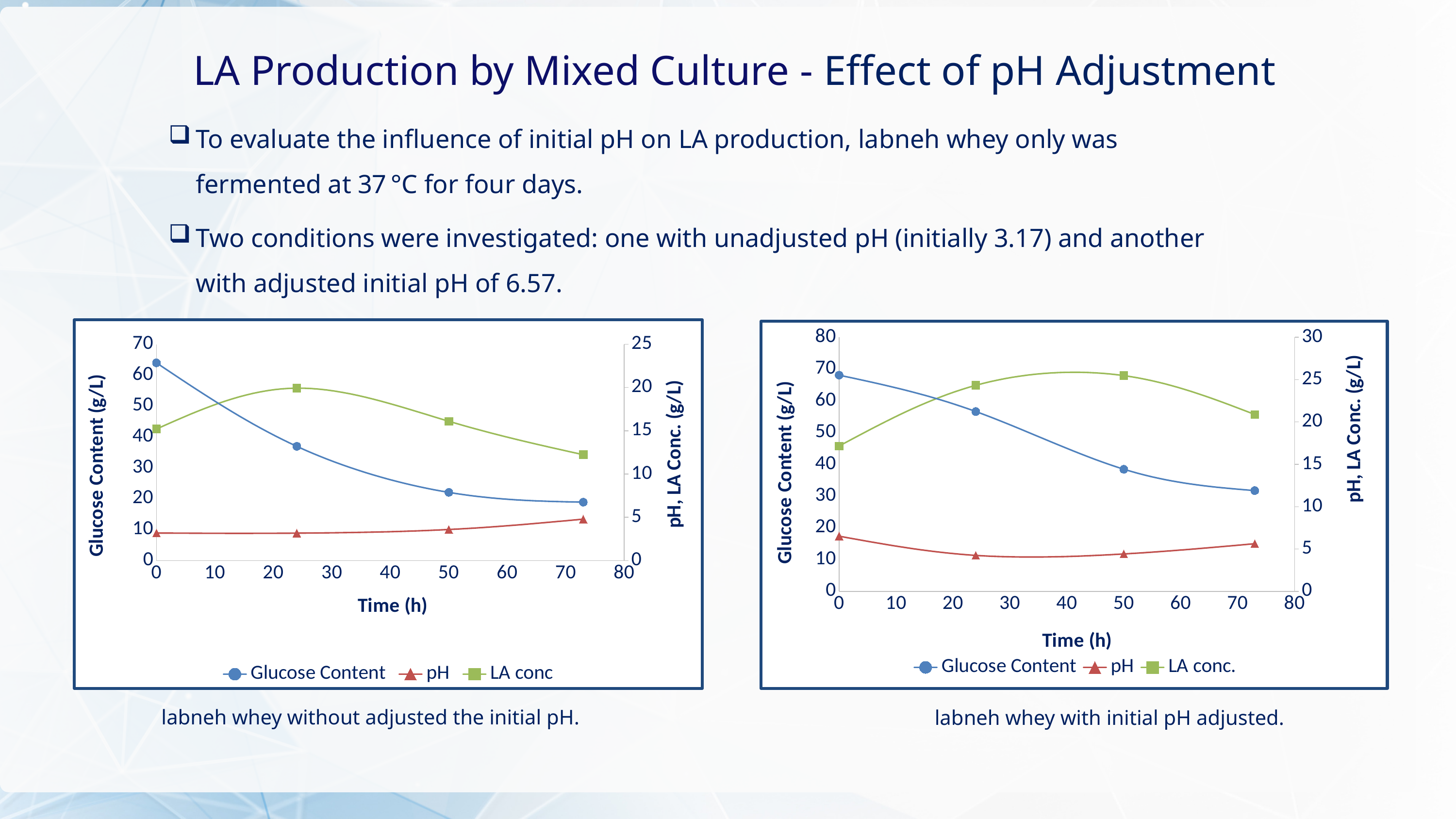
In the left chart (labneh whey without adjusted the initial pH), which series is drawn with triangle markers? pH In the left chart (labneh whey without adjusted the initial pH), how many data points are plotted for the Glucose Content series? 4 In the right chart (labneh whey with initial pH adjusted), is the LA conc. at about 50 h greater or less than 20 g/L on the right axis? greater In the right chart (labneh whey with initial pH adjusted), how many series does the legend list? 3 In the left chart (labneh whey without adjusted the initial pH), which is larger: the Glucose Content at 0 h or at about 73 h? 0 h In the left chart (labneh whey without adjusted the initial pH), what kind of chart is shown? line chart In the right chart (labneh whey with initial pH adjusted), what is the title of the left vertical axis? Glucose Content (g/L) In the right chart (labneh whey with initial pH adjusted), does the Glucose Content rise or fall as time increases? fall In the right chart (labneh whey with initial pH adjusted), is the Glucose Content at time 0 h greater or less than 60 g/L? greater In the left chart (labneh whey without adjusted the initial pH), is the Glucose Content at time 0 h greater or less than 60 g/L? greater